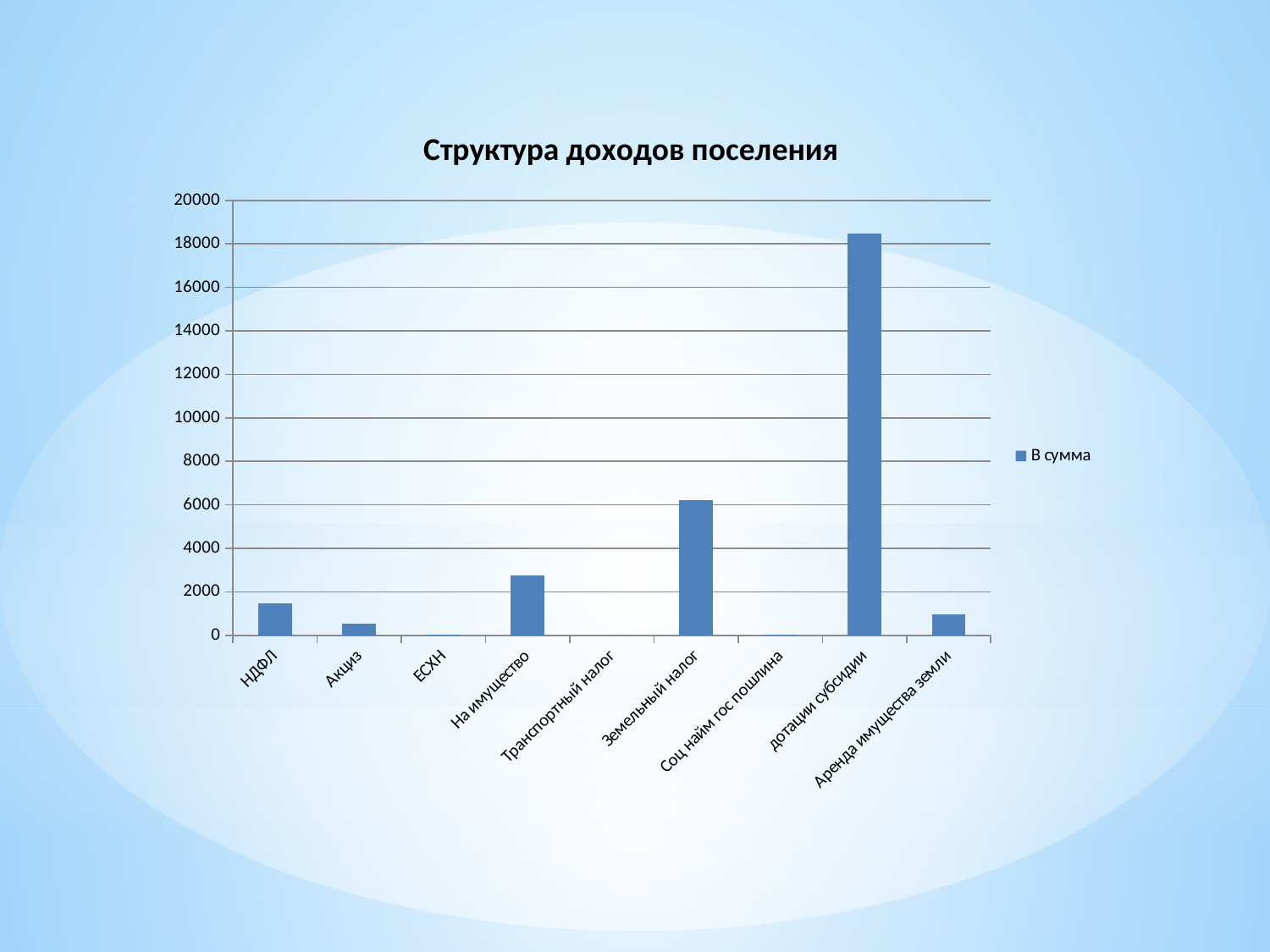
Is the value for дотации субсидии greater or less than 18000? greater How many categories are shown on the x axis? 9 Is the value for НДФЛ greater or less than 2000? less What is the title of the chart? Структура доходов поселения How many series does the legend list? 1 Which is larger, the value for НДФЛ or the value for Акциз? НДФЛ What is the name of the series shown in the legend? В сумма Is the value for На имущество greater or less than 2000? greater Which category has the highest value? дотации субсидии What kind of chart is shown on the slide? bar chart Which is larger, the value for Земельный налог or the value for На имущество? Земельный налог